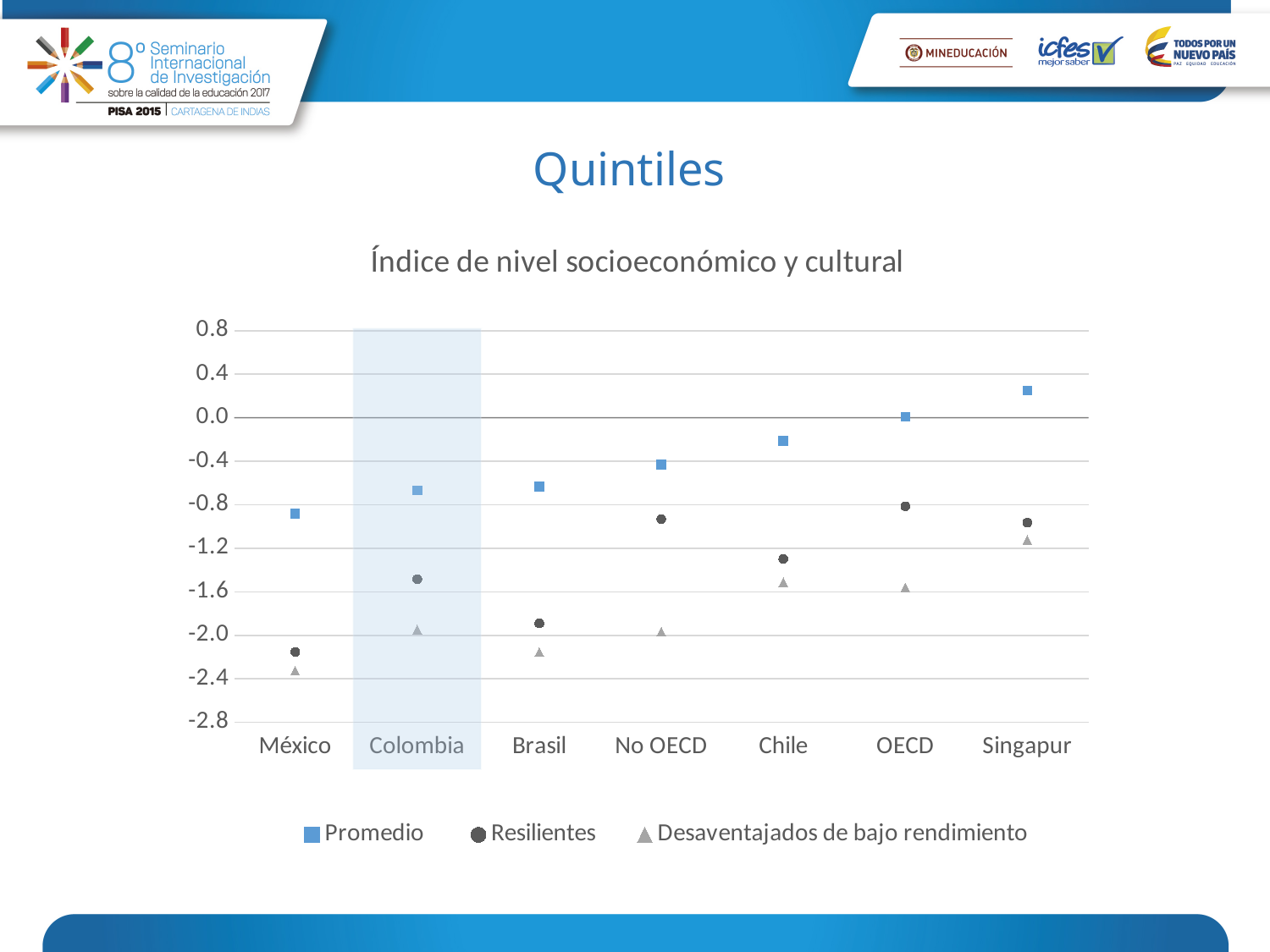
What is the title of the chart? Índice de nivel socioeconómico y cultural Which category has the highest Desaventajados de bajo rendimiento value? Singapur Is the Resilientes value for Colombia greater or less than -1.2? less How many categories are shown on the x axis? 7 Is the Promedio value for Chile greater or less than -0.4? greater Which is larger, the Resilientes value for Chile or for OECD? OECD Which category has the highest Promedio value? Singapur Which category has the lowest Desaventajados de bajo rendimiento value? México Which category has the lowest Resilientes value? México Which category has the lowest Promedio value? México Do the Promedio values rise or fall from México to Singapur along the x axis? rise How many series does the legend list? 3